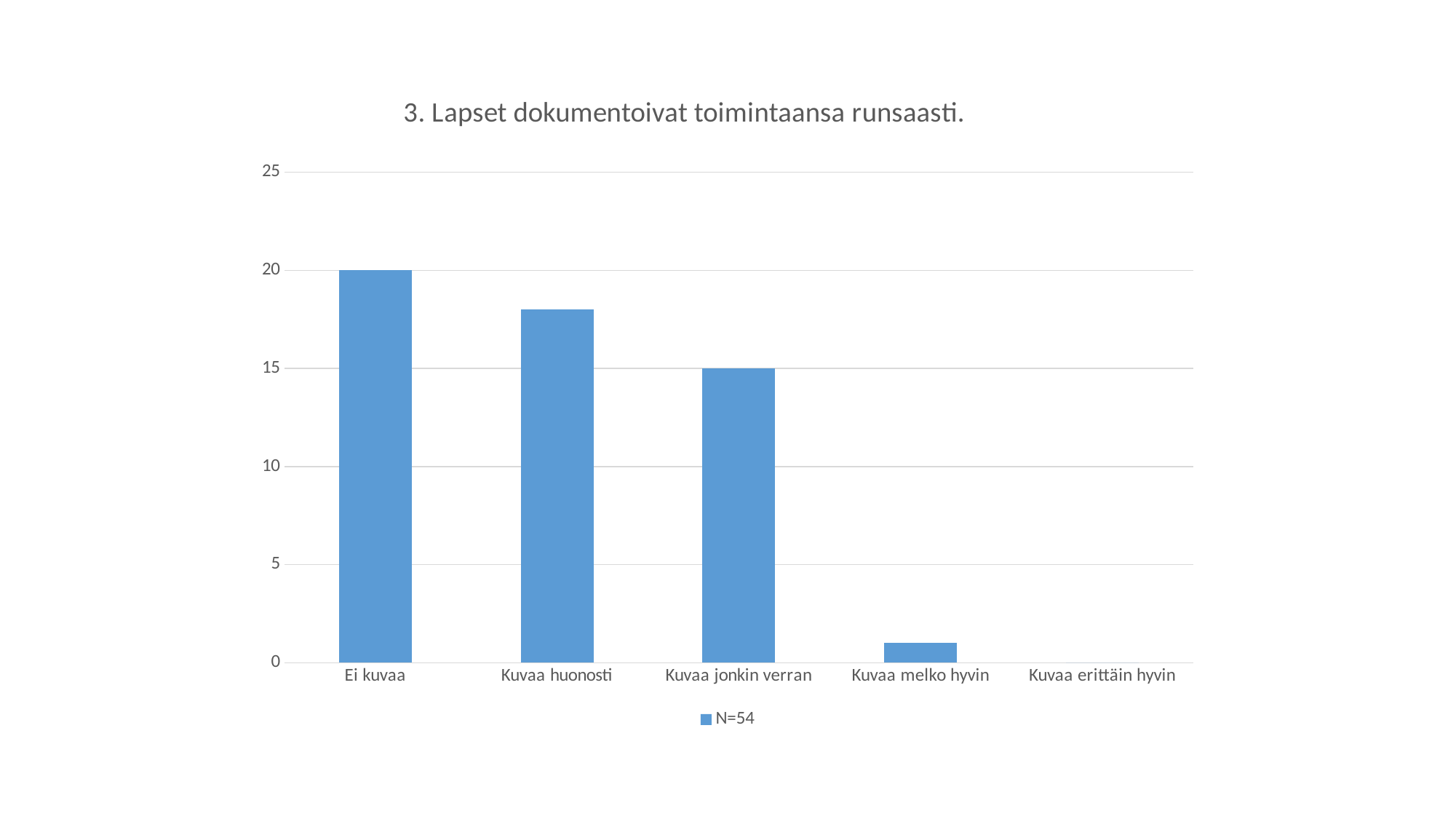
What is the value for Kuvaa jonkin verran? 15 What is the difference between the values for Ei kuvaa and Kuvaa jonkin verran? 5 Is the value for Kuvaa huonosti greater or less than 15? greater What type of chart is shown on the slide? bar chart What is the title of the chart? 3. Lapset dokumentoivat toimintaansa runsaasti. Is the value for Kuvaa melko hyvin greater or less than 5? less Which category has the lowest value? Kuvaa erittäin hyvin Do the values rise or fall from left to right along the x axis? fall Which category has the highest value? Ei kuvaa Which is larger, the value for Kuvaa huonosti or the value for Kuvaa melko hyvin? Kuvaa huonosti What is the value for Ei kuvaa? 20 How many categories are shown on the x axis? 5